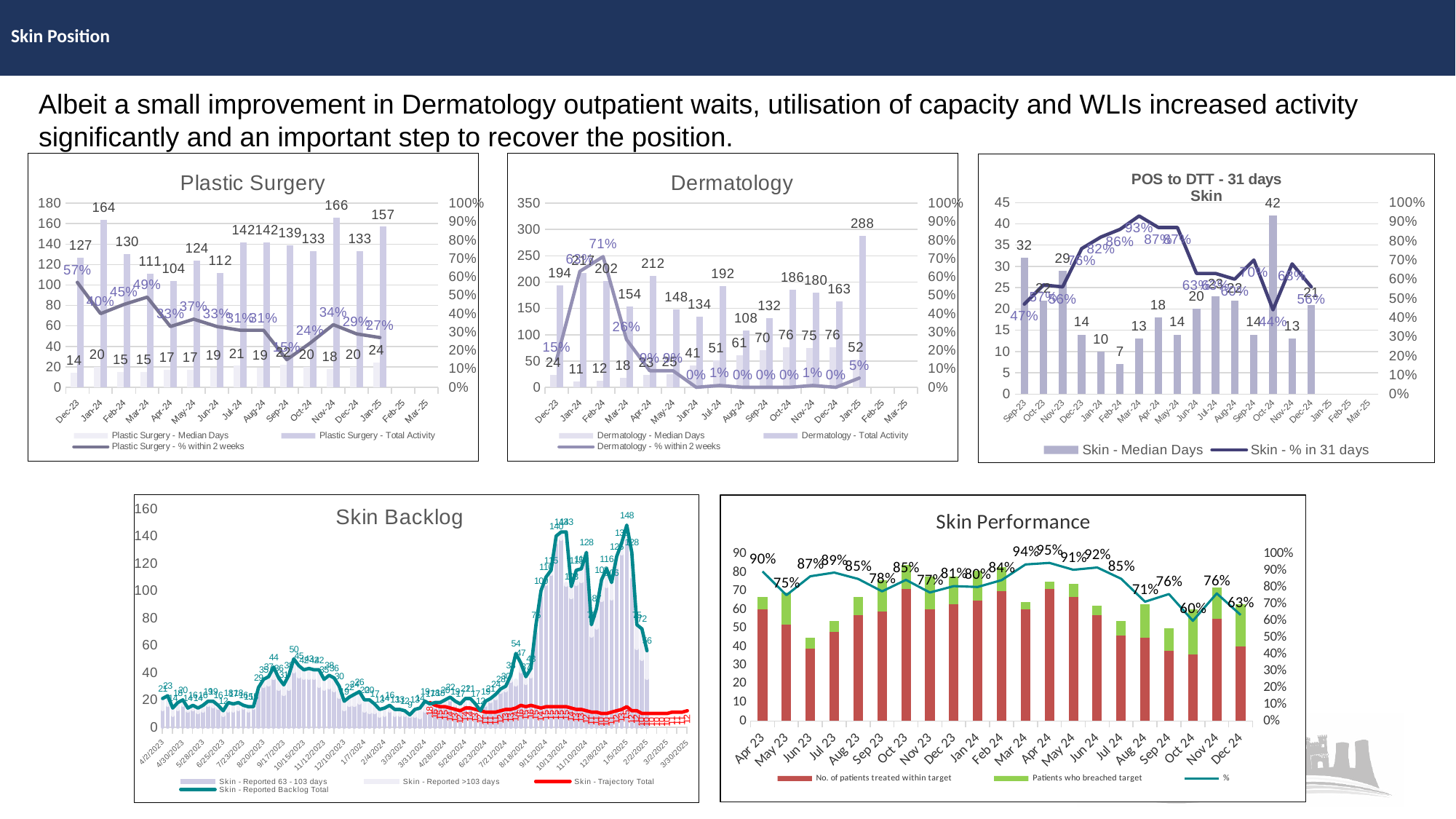
In the Skin Performance chart, what was the % in Apr 24? 95% In the Plastic Surgery chart, which month had the highest Plastic Surgery - Total Activity? Nov-24 In the POS to DTT - 31 days Skin chart, which month had the lowest Skin - Median Days? Feb-24 In the Plastic Surgery chart, what is the difference in Total Activity between Jan-25 and Dec-24? 24 In the Dermatology chart, which month had the lowest Dermatology - Total Activity? Aug-24 In the Dermatology chart, what was the Dermatology - % within 2 weeks in Feb-24? 71% In the POS to DTT - 31 days Skin chart, what was the Skin - Median Days in Oct-24? 42 In the Plastic Surgery chart, what was the Plastic Surgery - Total Activity in Nov-24? 166 How many series does the legend of the Skin Performance chart list? 3 In the Skin Performance chart, which is larger, the % for Oct 24 or the % for Nov 24? Nov 24 In the Dermatology chart, what was the Dermatology - Total Activity in Jan-25? 288 In the Plastic Surgery chart, what was the Plastic Surgery - % within 2 weeks in Dec-23? 57%